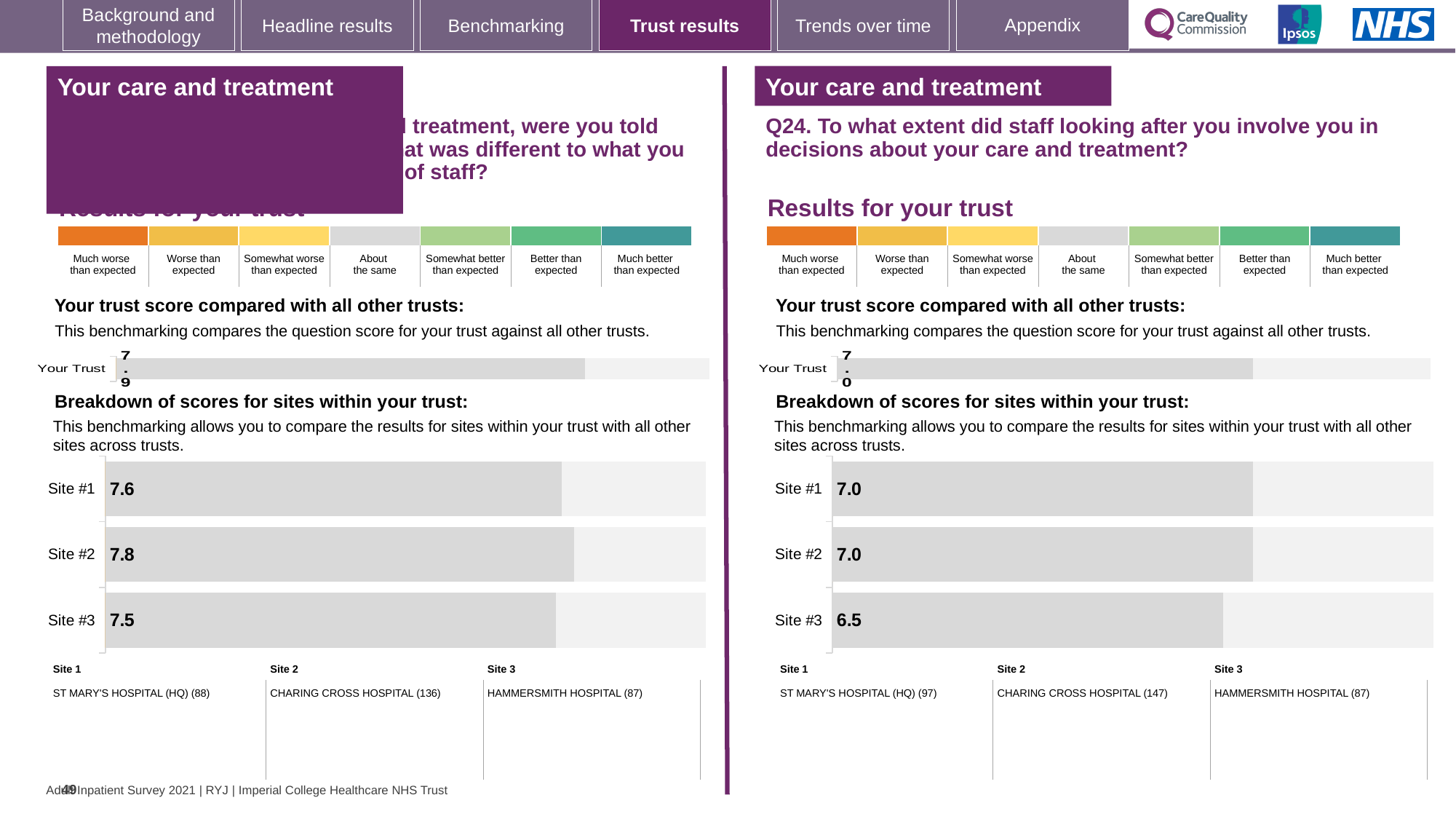
In the right-hand (Q24) site breakdown chart, which site has the lowest score? Site #3 In the left-hand site breakdown chart, which site has the lowest score? Site #3 In the left-hand site breakdown chart, what is the difference between the scores for Site #2 and Site #3? 0.3 In the right-hand (Q24) site breakdown chart, what is the score for Site #3? 6.5 In the left-hand site breakdown chart, which site has the highest score? Site #2 What type of chart is used for the site breakdown on the left-hand side of the slide? Bar chart What is the 'Your Trust' score shown in the right-hand (Q24) trust comparison chart? 7.0 How many sites are shown in the right-hand (Q24) site breakdown chart? 3 In the right-hand (Q24) site breakdown chart, what is the difference between the scores for Site #1 and Site #3? 0.5 In the left-hand site breakdown chart, which is larger: the score for Site #1 or Site #2? Site #2 What is the 'Your Trust' score shown in the left-hand trust comparison chart? 7.9 In the left-hand site breakdown chart, what is the score for Site #2? 7.8